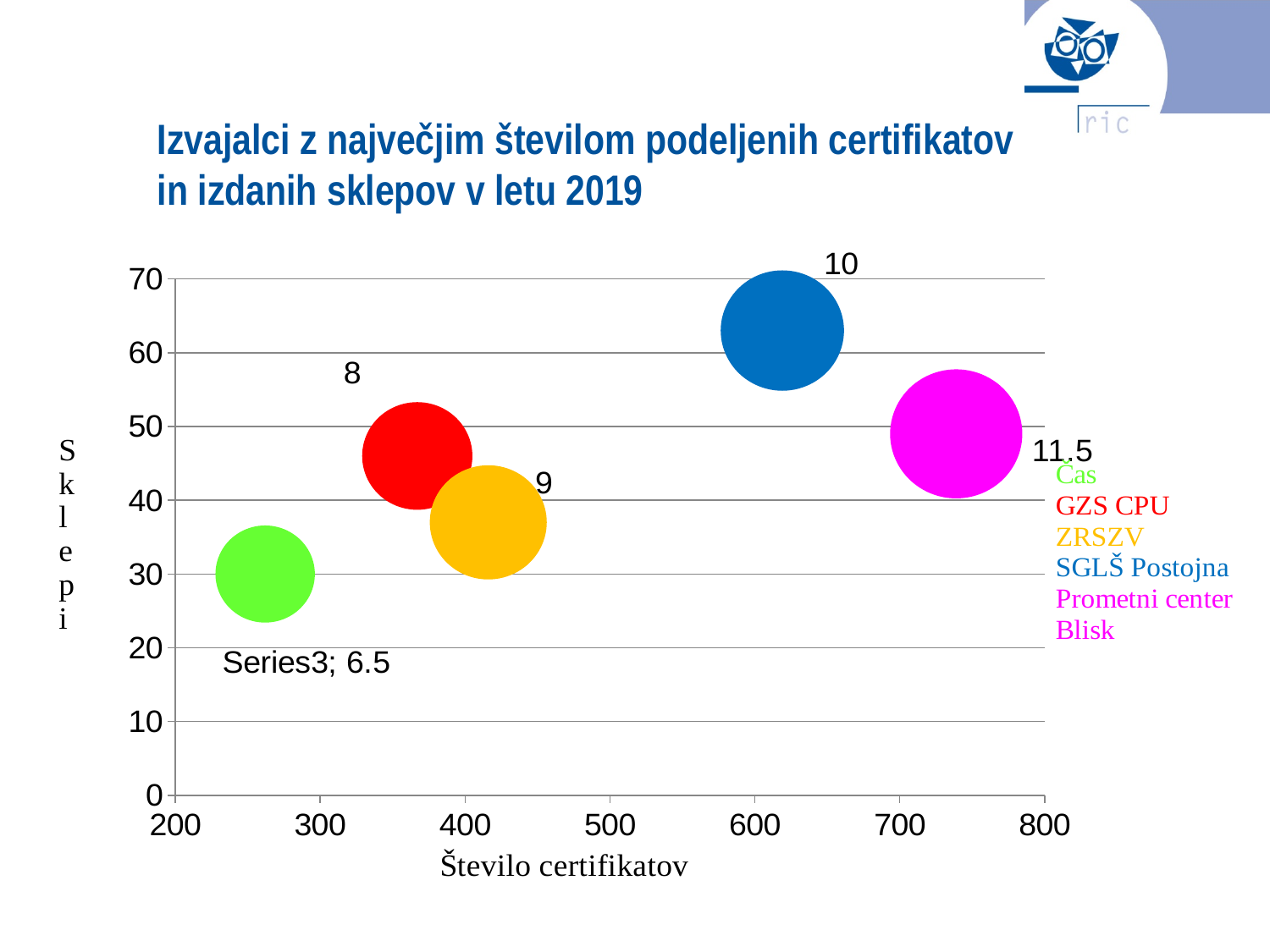
What kind of chart is shown on the slide? bubble chart What data label is printed next to the bubble for GZS CPU? 8 Is the Sklepi value for SGLŠ Postojna greater or less than 60? greater What data label is printed next to the bubble for SGLŠ Postojna? 10 What is the title of the x axis? Število certifikatov Which provider has the lowest number of certificates (Število certifikatov)? Čas What data label is printed next to the bubble for Prometni center Blisk? 11.5 Which has more certificates, GZS CPU or ZRSZV? ZRSZV Which provider has the highest number of Sklepi (y axis)? SGLŠ Postojna How many series does the legend list? 5 Is the number of certificates for Prometni center Blisk greater or less than 700? greater How many bubbles are plotted on the chart? 5